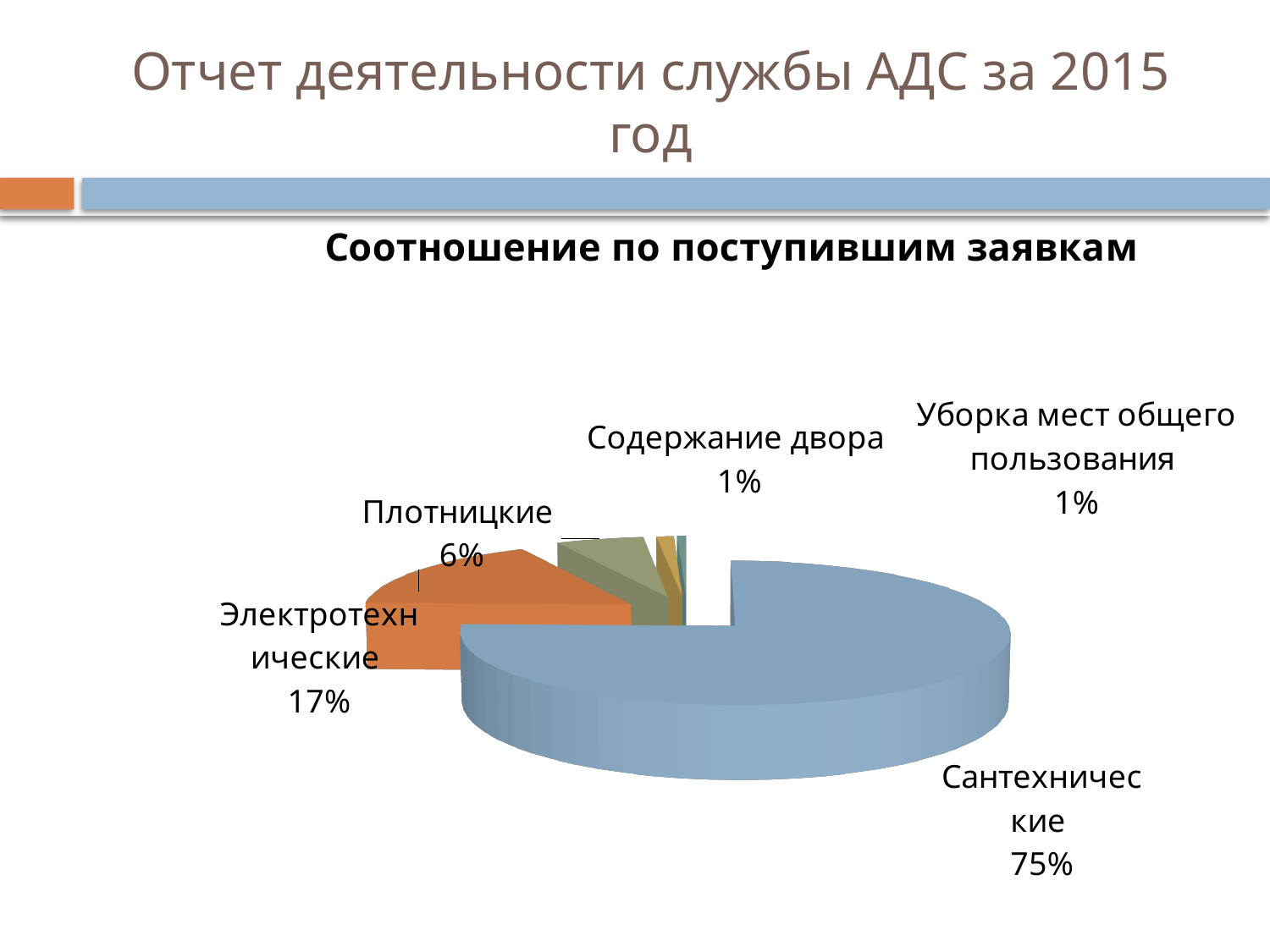
What share of the pie is labelled Сантехнические? 75% What colour is the Сантехнические slice? Blue What type of chart is shown on the slide? Pie chart Which is larger, the share for Электротехнические or the share for Плотницкие? Электротехнические What is the difference in percentage points between Сантехнические and Электротехнические? 58 What share of the pie is labelled Электротехнические? 17% What share of the pie is labelled Плотницкие? 6% Which category has the largest slice of the pie? Сантехнические What is the title of the chart? Соотношение по поступившим заявкам How many slices does the pie chart have? 5